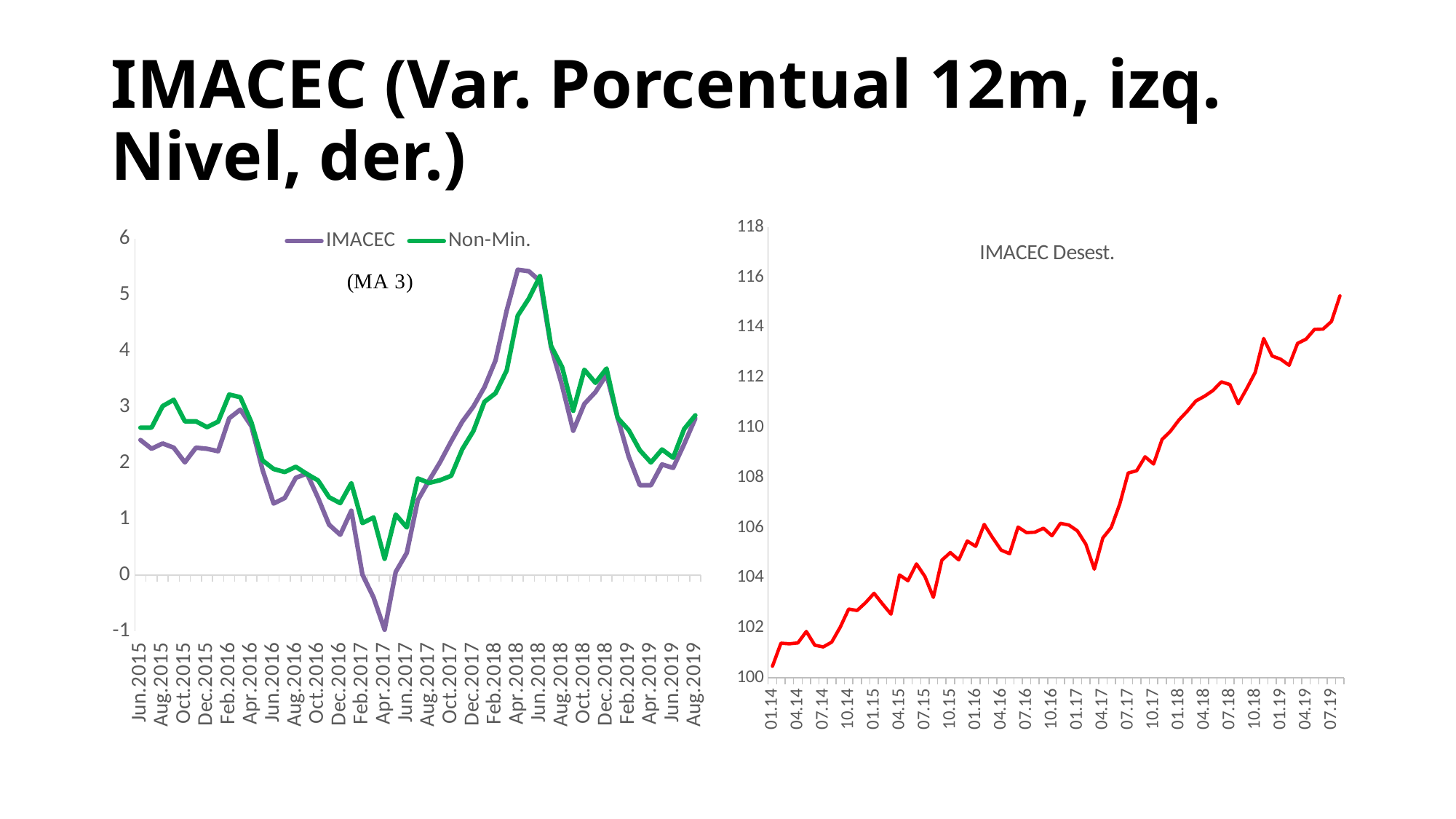
How many series does the legend of the left chart list? 2 What type of chart is the left chart (IMACEC / Non-Min.)? line chart In the left chart, is the IMACEC value for Apr.2017 greater or less than 0? less What type of chart is the right chart titled 'IMACEC Desest.'? line chart What is the title shown on the right chart? IMACEC Desest. In the left chart, is the Non-Min. value for Apr.2017 greater or less than 0? greater In the left chart, is the IMACEC value for Apr.2018 greater or less than 5? greater In the left chart, which series has the higher value at Apr.2017, IMACEC or Non-Min.? Non-Min. In the right chart 'IMACEC Desest.', do the values generally rise or fall from 01.14 to 07.19? rise What are the two series named in the legend of the left chart? IMACEC and Non-Min.